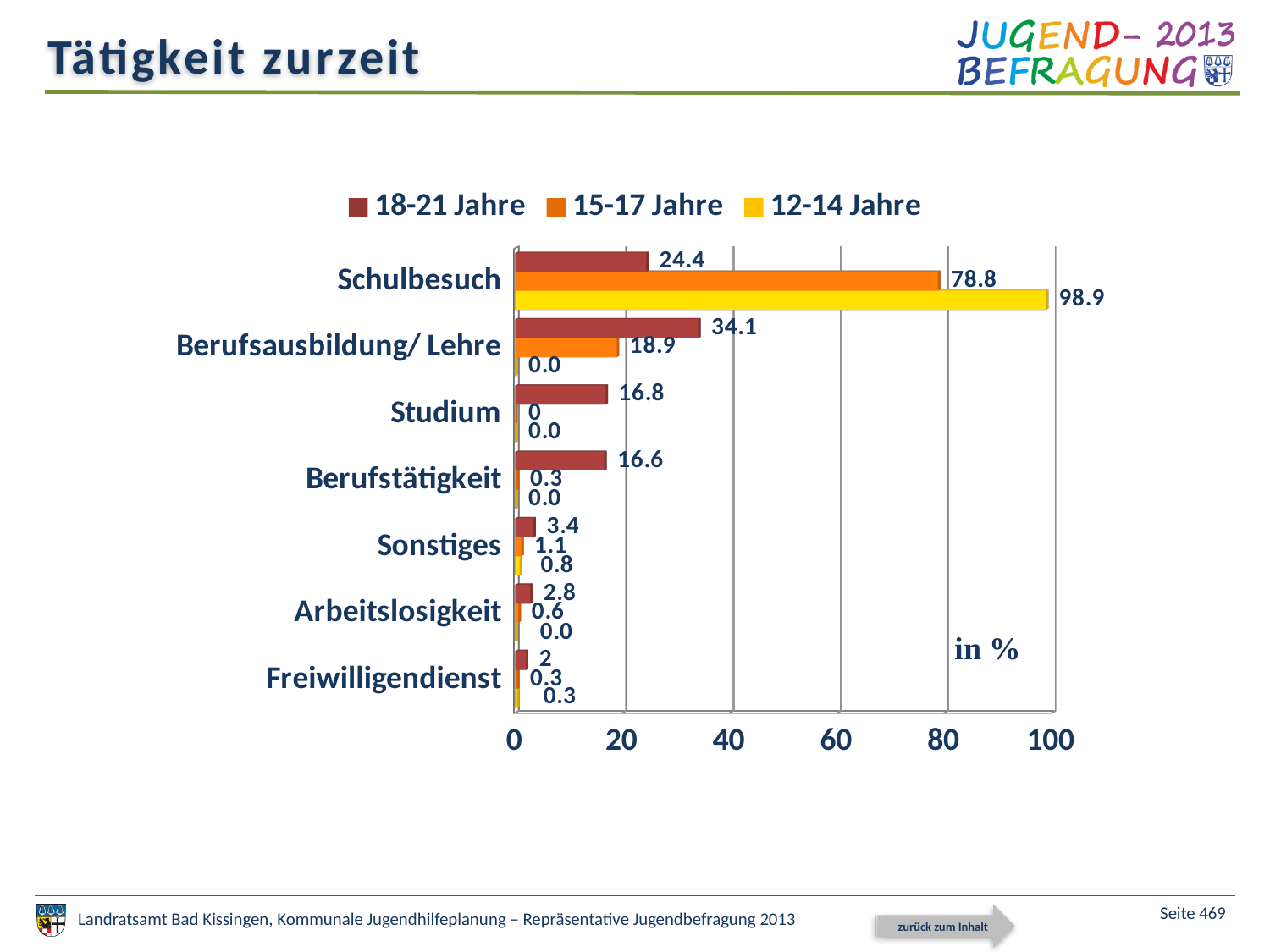
What is the value for Schulbesuch in the 12-14 Jahre series? 98.9 Which colour represents the 12-14 Jahre series? Yellow What is the value for Berufsausbildung/ Lehre in the 18-21 Jahre series? 34.1 Which is larger for Berufsausbildung/ Lehre: the 18-21 Jahre value or the 15-17 Jahre value? 18-21 Jahre What kind of chart is shown on the slide? Bar chart Which category has the highest value in the 18-21 Jahre series? Berufsausbildung/ Lehre What is the value for Studium in the 18-21 Jahre series? 16.8 How many series does the legend list? 3 What is the difference between the 12-14 Jahre and 15-17 Jahre values for Schulbesuch? 20.1 Which category has the lowest value in the 18-21 Jahre series? Freiwilligendienst How many categories are shown on the chart? 7 What is the value for Schulbesuch in the 15-17 Jahre series? 78.8